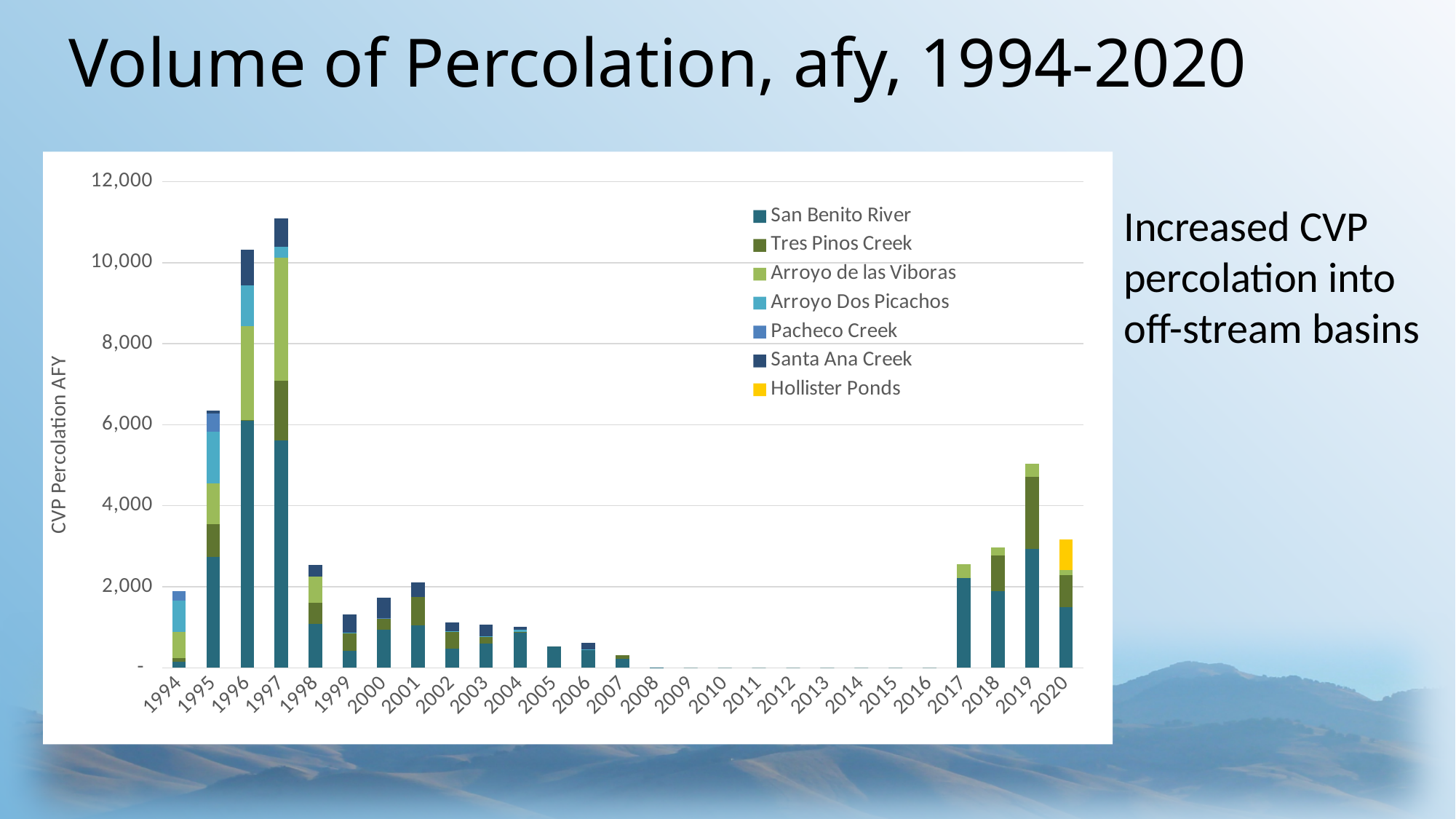
Is the total value for 2005 greater or less than 1,000? less Which year has the larger total, 2018 or 2019? 2019 Is the total value for 2017 greater or less than 2,000? greater Which year has the larger total, 1995 or 1996? 1996 What kind of chart is shown on the slide? Stacked bar chart In which year does the Hollister Ponds series appear in the chart? 2020 How many series does the legend list? 7 Which year has the highest total CVP percolation? 1997 Is the total value for 2019 greater or less than 4,000? greater How many years are shown along the x axis? 27 Do the total values rise or fall from 1997 to 2007? fall